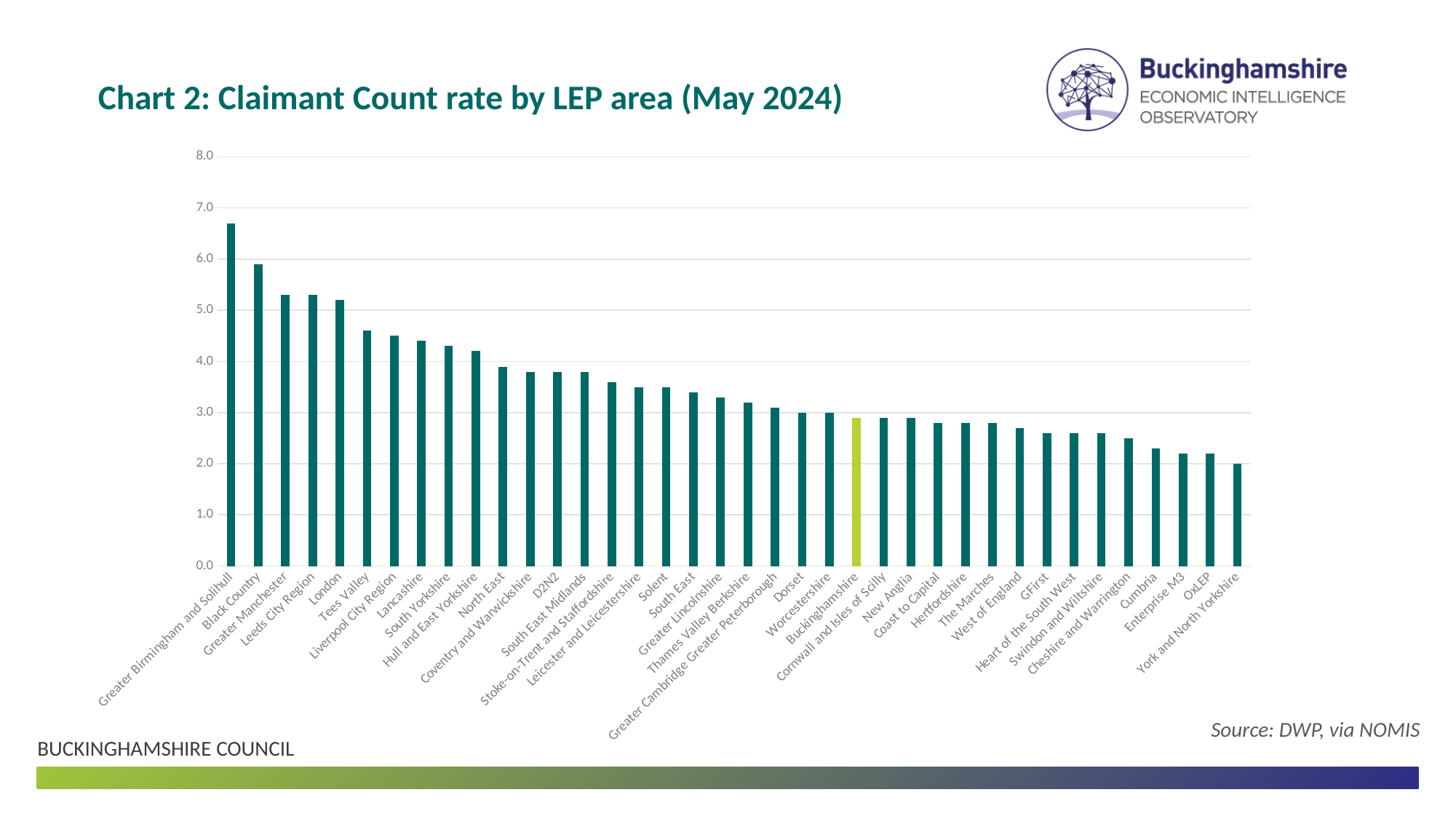
Is the claimant count rate for Greater Birmingham and Solihull greater or less than 6.0? greater Is the claimant count rate for Solent greater or less than 3.0? greater Is the claimant count rate for Cumbria greater or less than 3.0? less Do the claimant count rates rise or fall moving from left to right along the x axis? Fall Which LEP area has the highest claimant count rate? Greater Birmingham and Solihull How many LEP areas are plotted on the chart? 38 Which LEP area's bar is highlighted in a different (light green) colour from the others? Buckinghamshire Which has the higher claimant count rate, Black Country or Greater Manchester? Black Country What kind of chart is shown on the slide? Bar chart Which LEP area has the lowest claimant count rate? York and North Yorkshire Which has the higher claimant count rate, London or Tees Valley? London